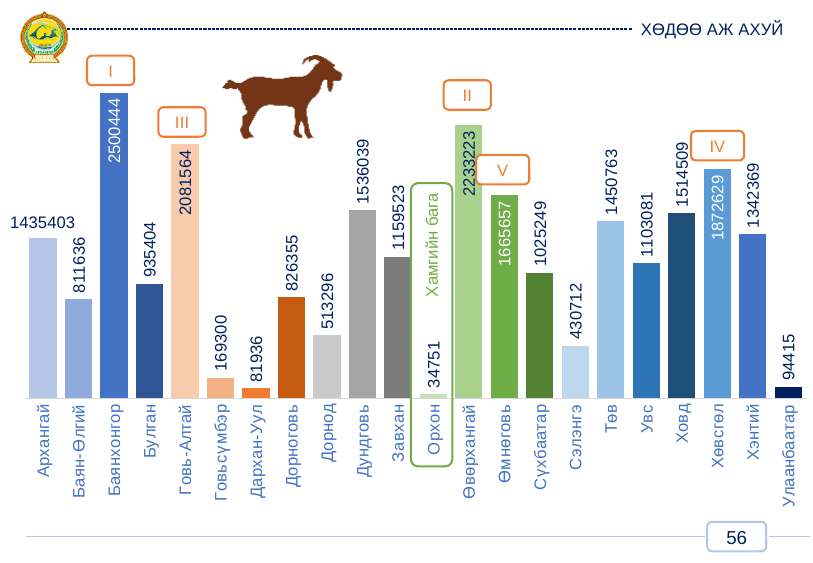
How many categories are shown on the chart? 22 Which category has the highest value? Баянхонгор What is the difference between the values for Баянхонгор and Өвөрхангай? 267221 What is the value shown for Хөвсгөл? 1872629 Which category's bar is marked with the label "Хамгийн бага"? Орхон Which category has the lowest value? Орхон What is the value shown for Сэлэнгэ? 430712 What kind of chart is shown on the slide? Bar chart What is the value shown for Орхон? 34751 What is the value shown for Баянхонгор? 2500444 Which has a larger value, Дундговь or Ховд? Дундговь What is the difference between the values for Говь-Алтай and Хөвсгөл? 208935